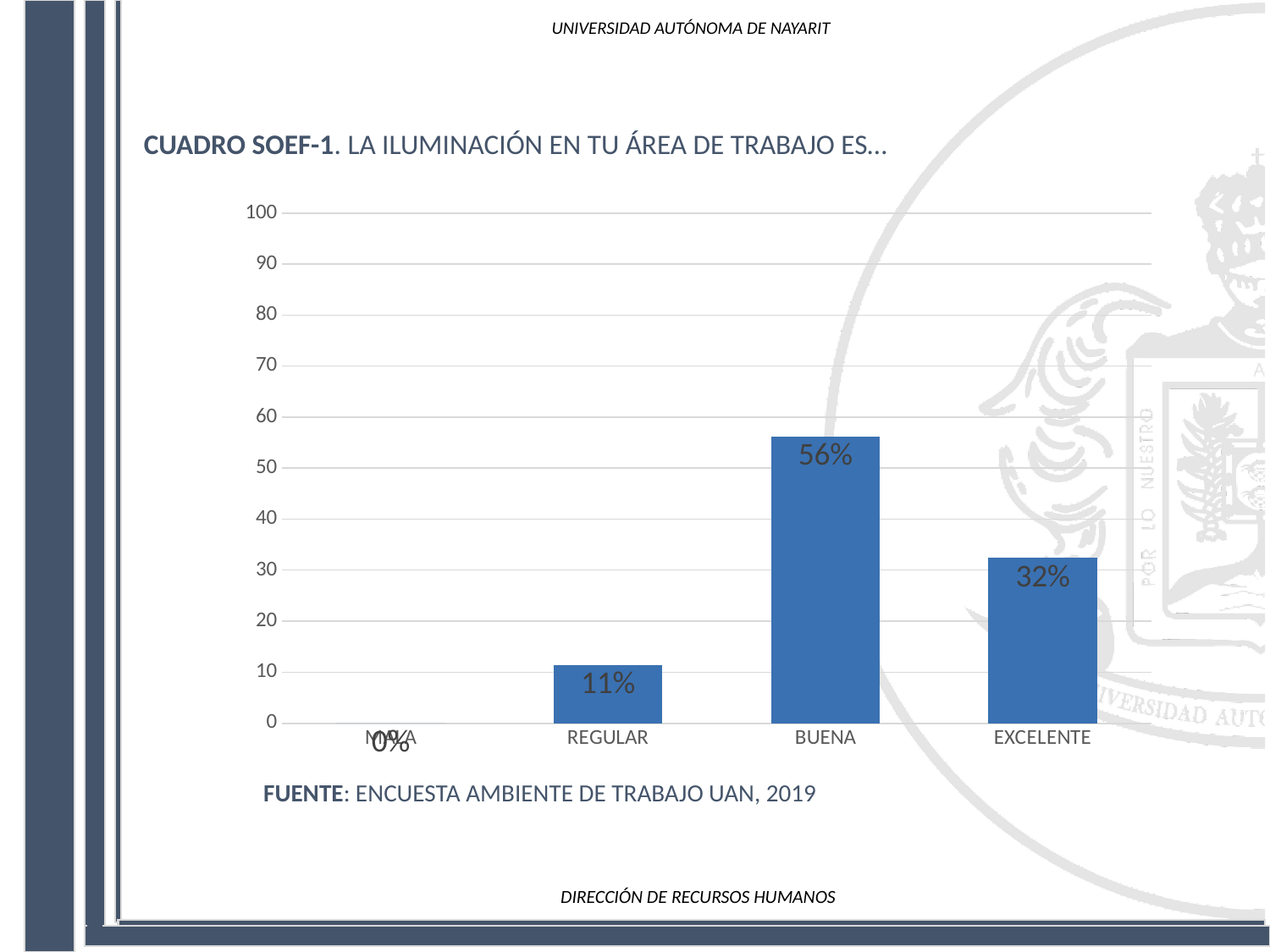
How many categories are shown on the x axis? 4 What is the difference between the values for BUENA and EXCELENTE? 24% Which category has the highest value? BUENA Which is larger, the value for REGULAR or the value for EXCELENTE? EXCELENTE Is the value for EXCELENTE greater or less than 40? less What is the value for EXCELENTE? 32% What is the value for REGULAR? 11% What source is cited below the chart? ENCUESTA AMBIENTE DE TRABAJO UAN, 2019 What is the difference between the values for EXCELENTE and REGULAR? 21% What is the value for BUENA? 56% Is the value for BUENA greater or less than 50? greater What kind of chart is shown on the slide? bar chart